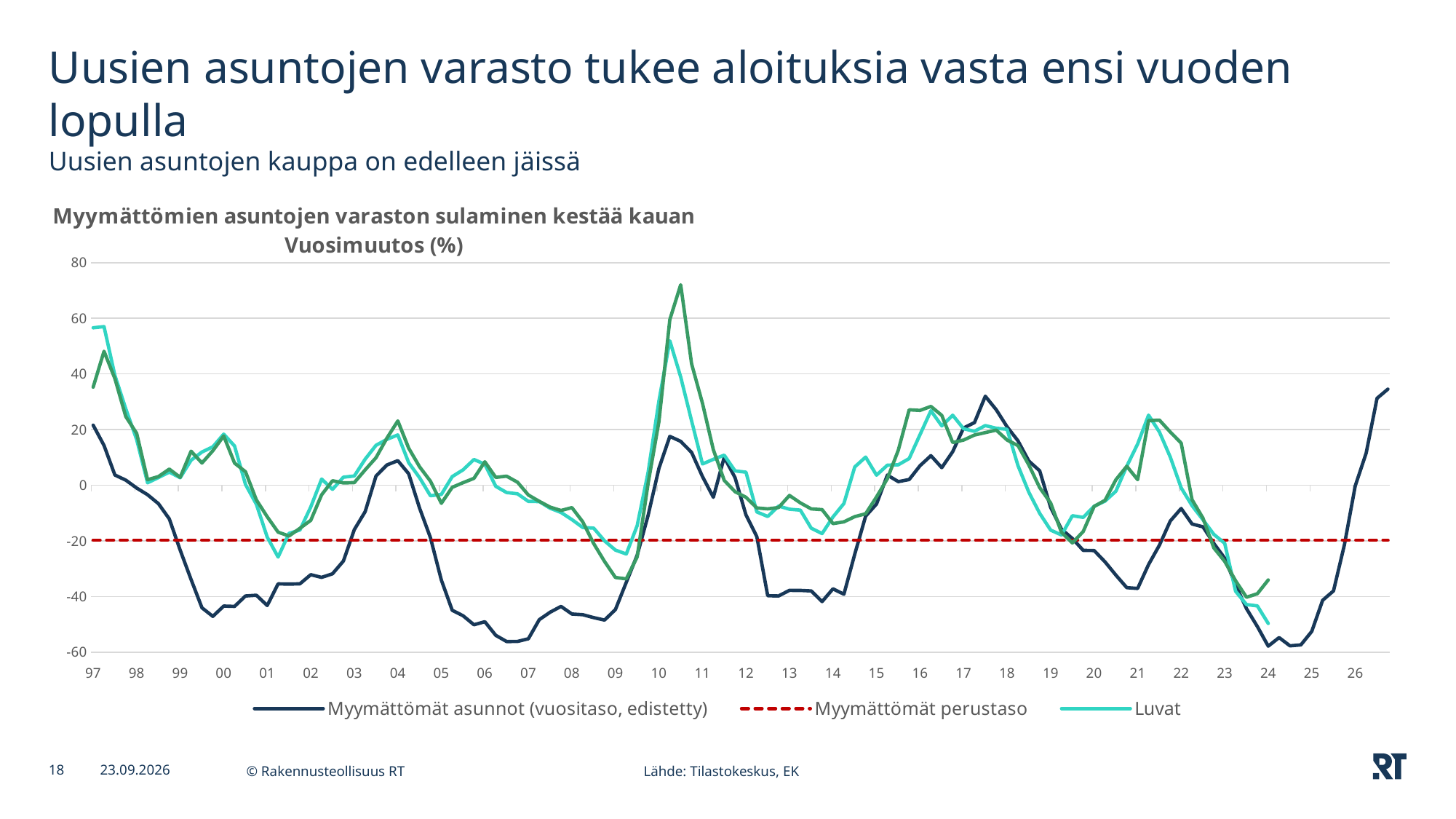
Is the value of 'Myymättömät asunnot (vuositaso, edistetty)' around 24 greater or less than -40? less How many series does the legend list? 3 What is the highest value shown on the y axis? 80 What is the title of the chart? Myymättömien asuntojen varaston sulaminen kestää kauan Is the value of 'Myymättömät asunnot (vuositaso, edistetty)' at the end of the series (26) greater or less than 20? greater At what value does the dashed 'Myymättömät perustaso' line sit? -20 How many year labels are shown on the x axis? 30 What kind of chart is shown on the slide? Line chart What unit is shown in the chart's subtitle? Vuosimuutos (%) Is the peak of the 'Luvat' line around 10 greater or less than 40? greater Does the 'Myymättömät asunnot (vuositaso, edistetty)' line rise or fall between 24 and 26? rise